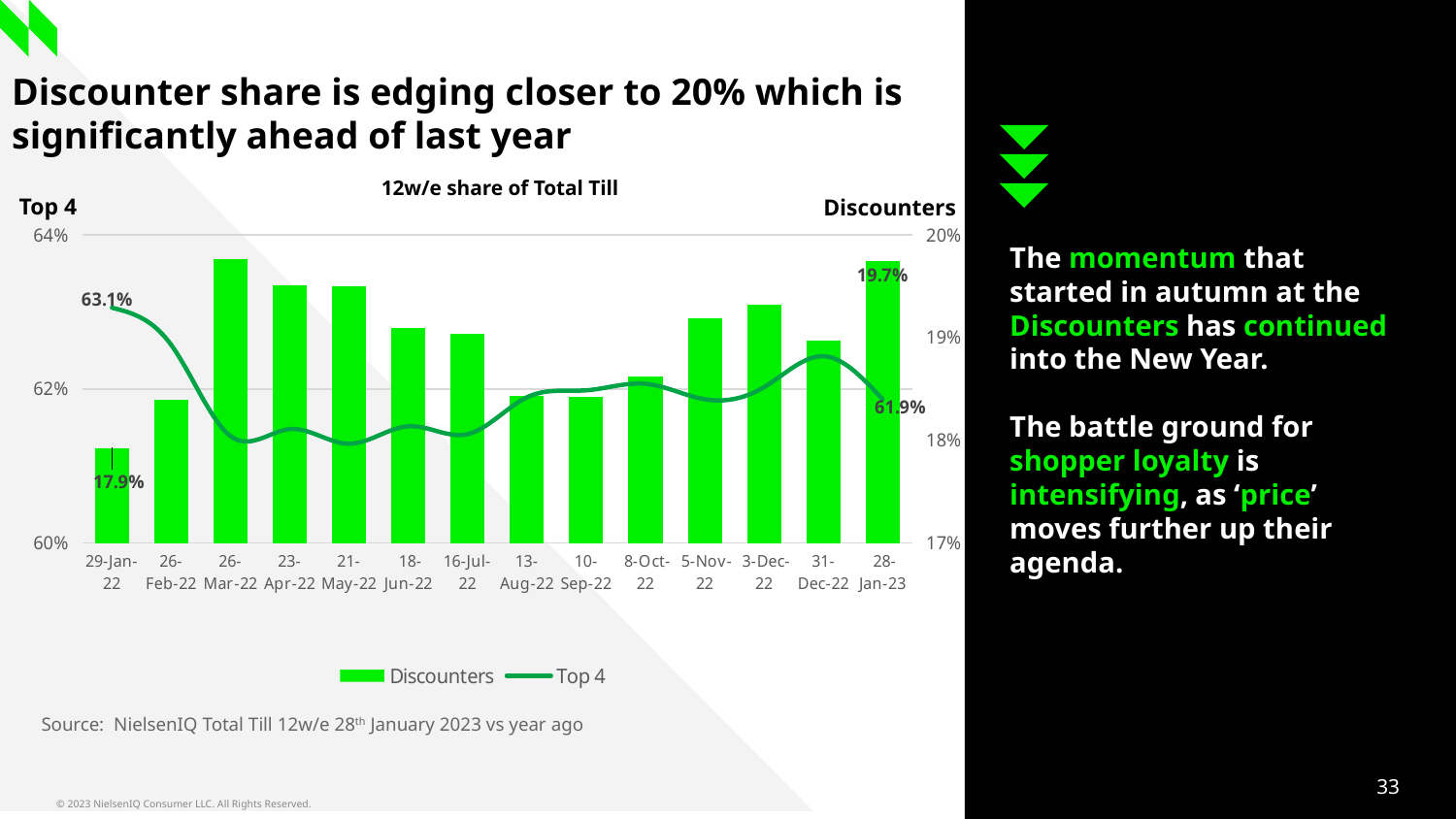
What kind of chart is shown on the slide? Combination bar and line chart What is the Discounters share for 28-Jan-23? 19.7% By how many percentage points did the Discounters share rise from 29-Jan-22 to 28-Jan-23? 1.8 percentage points Which period has the lowest Discounters share? 29-Jan-22 How many series does the chart legend list? 2 Is the Discounters share for 26-Mar-22 greater or less than 19%? greater What is the Top 4 share for 28-Jan-23? 61.9% Does the Top 4 share line rise or fall overall from 29-Jan-22 to 28-Jan-23? Fall What is the Discounters share for 29-Jan-22? 17.9% How many time periods are shown on the x axis of the chart? 14 By how many percentage points did the Top 4 share fall from 29-Jan-22 to 28-Jan-23? 1.2 percentage points What is the Top 4 share for 29-Jan-22? 63.1%